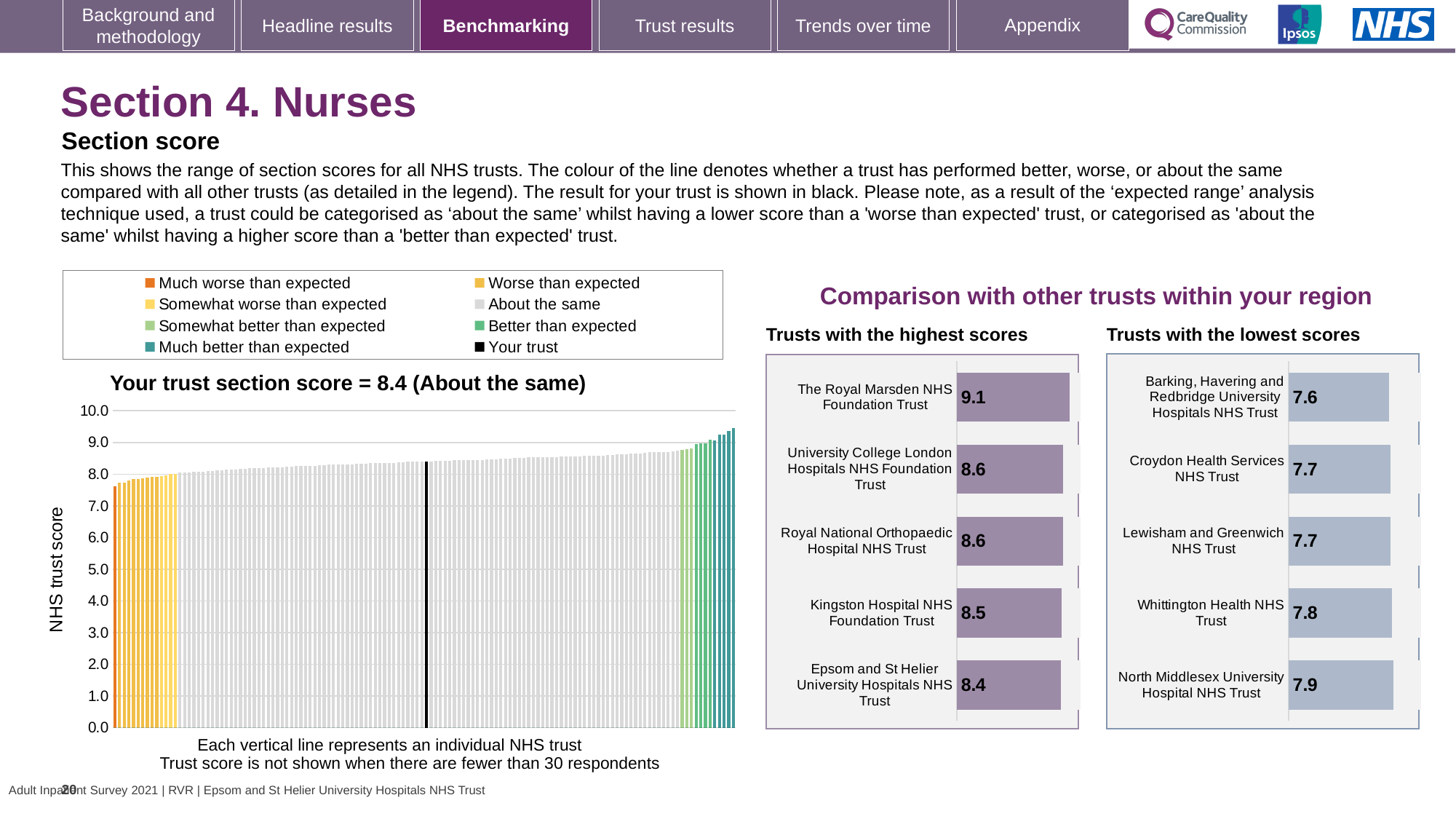
In the main chart on the left, do the trust scores rise or fall from left to right along the x axis? rise What is the section score for your trust shown in the main chart on the left? 8.4 In the 'Trusts with the highest scores' chart, which trust has the highest score? The Royal Marsden NHS Foundation Trust In the 'Trusts with the highest scores' chart, what is the score for Kingston Hospital NHS Foundation Trust? 8.5 In the 'Trusts with the lowest scores' chart, what is the score for Whittington Health NHS Trust? 7.8 How many entries does the legend above the main chart on the left list? 8 In the 'Trusts with the lowest scores' chart, which has the higher score: Croydon Health Services NHS Trust or North Middlesex University Hospital NHS Trust? North Middlesex University Hospital NHS Trust In the 'Trusts with the highest scores' chart, what is the difference between the scores of The Royal Marsden NHS Foundation Trust and Epsom and St Helier University Hospitals NHS Trust? 0.7 In the 'Trusts with the lowest scores' chart, which trust has the lowest score? Barking, Havering and Redbridge University Hospitals NHS Trust In the 'Trusts with the lowest scores' chart, what is the score for Barking, Havering and Redbridge University Hospitals NHS Trust? 7.6 In the 'Trusts with the highest scores' chart, what is the score for The Royal Marsden NHS Foundation Trust? 9.1 How many trusts are shown in the 'Trusts with the lowest scores' chart? 5